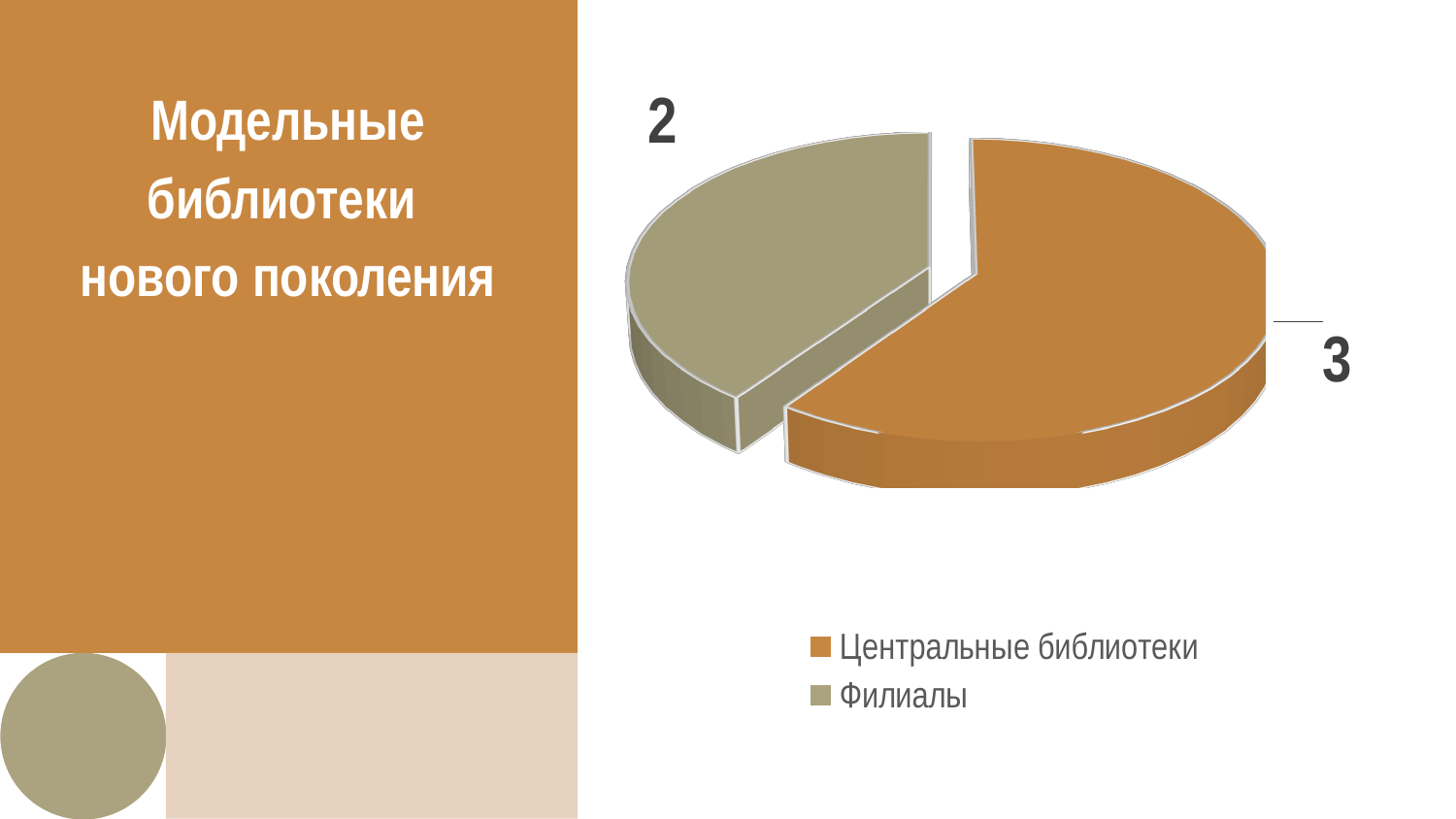
Which is larger, the value for Центральные библиотеки or for Филиалы? Центральные библиотеки What kind of chart is shown on the slide? pie chart Which category has the largest slice? Центральные библиотеки What colour is the slice for Филиалы? grey-green (khaki) Which category has the smallest slice? Филиалы What is the difference between the values for Центральные библиотеки and Филиалы? 1 What is the value for Центральные библиотеки? 3 What is the value for Филиалы? 2 How many entries does the legend list? 2 What share of the pie does Центральные библиотеки represent? 60% How many slices does the pie chart have? 2 What is the total of all slices in the pie chart? 5